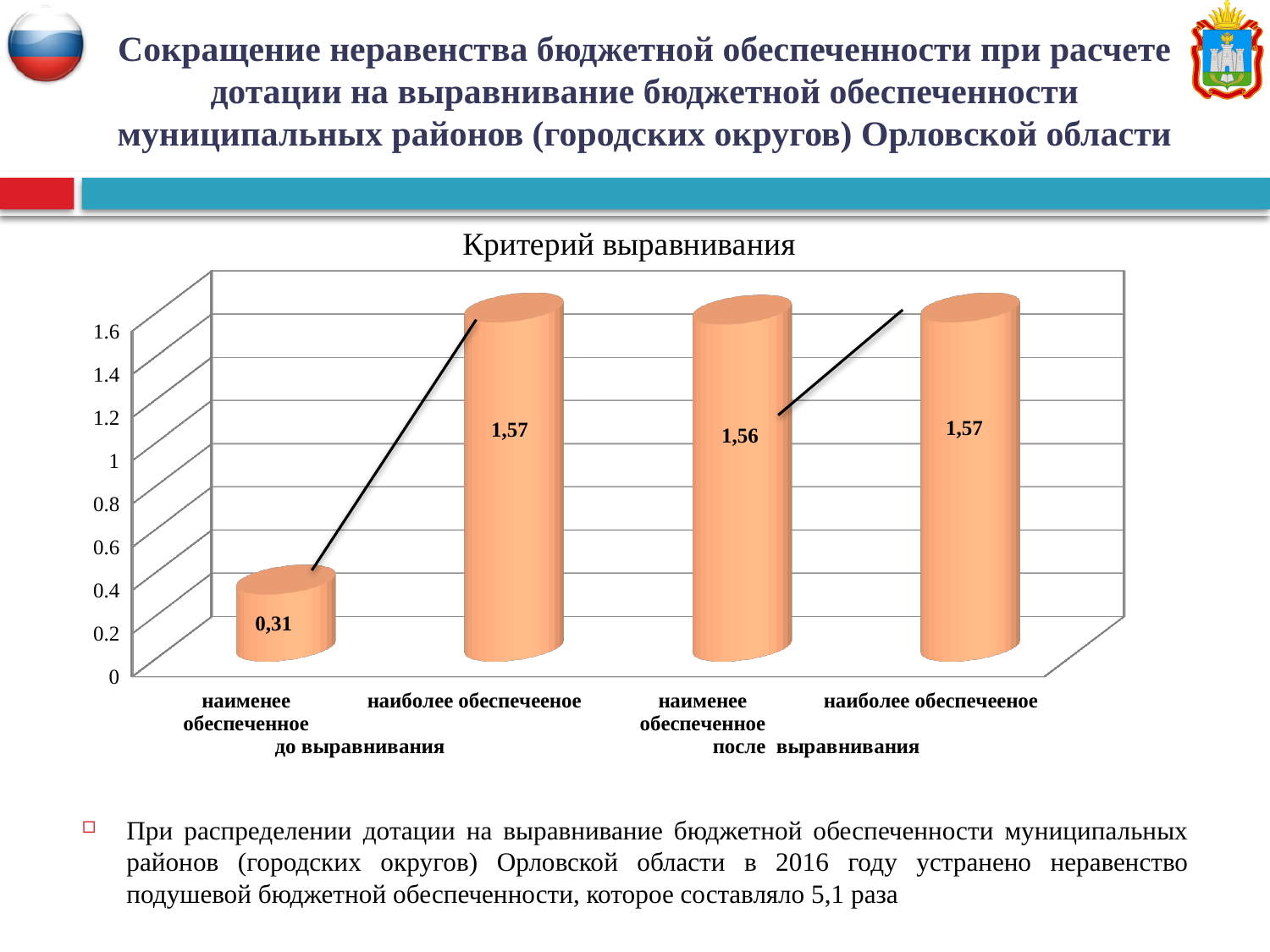
What is the difference between 'наиболее обеспечееное' and 'наименее обеспеченное' before equalisation (до выравнивания)? 1,26 What is the value for 'наименее обеспеченное' before equalisation (до выравнивания)? 0,31 What is the title of the chart? Критерий выравнивания Which is larger: 'наименее обеспеченное' before equalisation or 'наименее обеспеченное' after equalisation? наименее обеспеченное after equalisation (после выравнивания) What is the value for 'наименее обеспеченное' after equalisation (после выравнивания)? 1,56 What kind of chart is shown on the slide? bar chart What is the value for 'наиболее обеспечееное' after equalisation (после выравнивания)? 1,57 Which bar has the lowest value? наименее обеспеченное (до выравнивания) Is the value for 'наименее обеспеченное' before equalisation greater or less than 0.4? less What is the value for 'наиболее обеспечееное' before equalisation (до выравнивания)? 1,57 What is the difference between the 'наименее обеспеченное' values after and before equalisation? 1,25 How many bars are plotted in the chart? 4